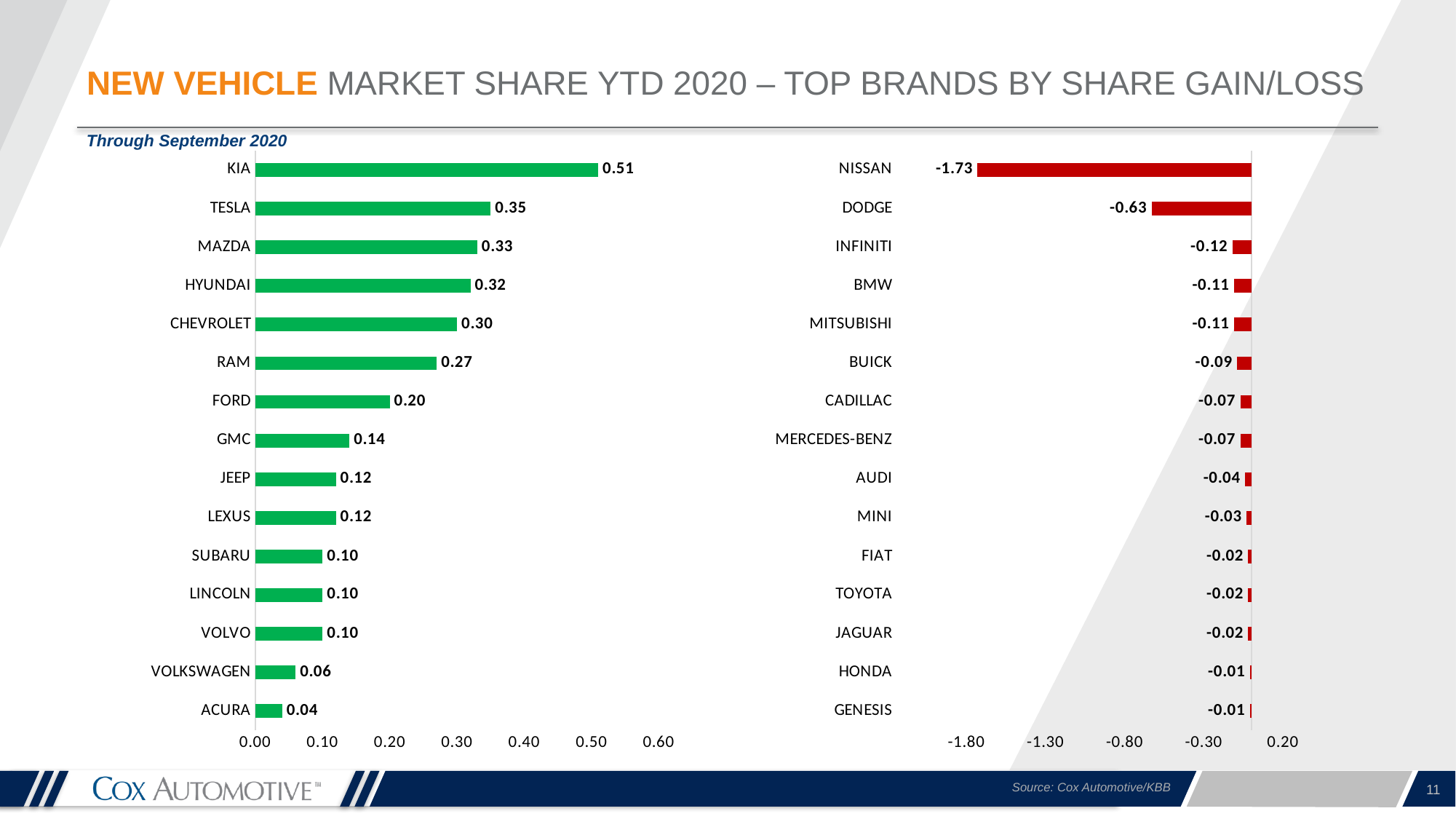
In the left chart (share gains), which brand has the lowest value? ACURA In the right chart (share losses), what is the value for NISSAN? -1.73 In the left chart (share gains), which is larger, the value for MAZDA or the value for FORD? MAZDA In the left chart (share gains), how many brands are shown? 15 In the left chart (share gains), what is the difference between the values for KIA and TESLA? 0.16 In the left chart (share gains), what is the value for KIA? 0.51 In the right chart (share losses), how many brands are shown? 15 In the right chart (share losses), which brand has the largest loss? NISSAN In the right chart (share losses), what is the difference between the values for NISSAN and DODGE? 1.10 What kind of chart is used on this slide? Bar chart In the left chart (share gains), which brand has the highest value? KIA In the left chart (share gains), what is the value for VOLKSWAGEN? 0.06